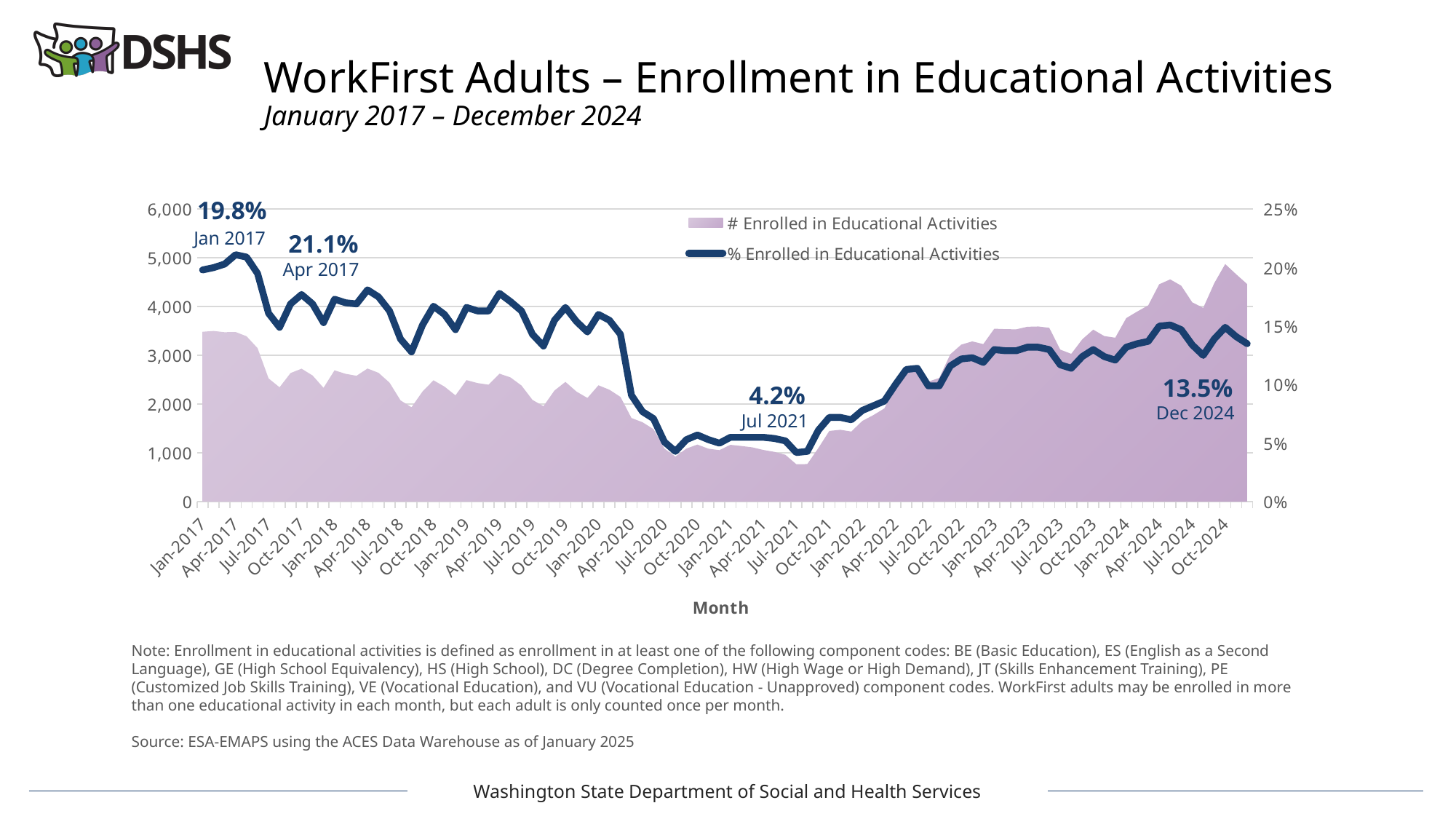
Does the % Enrolled in Educational Activities generally rise or fall between Jul 2021 and Dec 2024? rise Is the # Enrolled in Educational Activities in Jan 2017 greater or less than 3,000? greater What was the % Enrolled in Educational Activities in Apr 2017? 21.1% Of the four labeled percentage points on the chart, which month has the highest % Enrolled in Educational Activities? Apr 2017 How many series does the legend list? 2 Is the # Enrolled in Educational Activities in Oct 2020 greater or less than 2,000? less Which is larger: the % Enrolled in Educational Activities in Apr 2017 or in Dec 2024? Apr 2017 What was the % Enrolled in Educational Activities in Jul 2021? 4.2% What was the % Enrolled in Educational Activities in Dec 2024? 13.5% What was the % Enrolled in Educational Activities in Jan 2017? 19.8% Of the four labeled percentage points on the chart, which month has the lowest % Enrolled in Educational Activities? Jul 2021 By how many percentage points did the % Enrolled in Educational Activities fall from Apr 2017 to Jul 2021? 16.9 percentage points